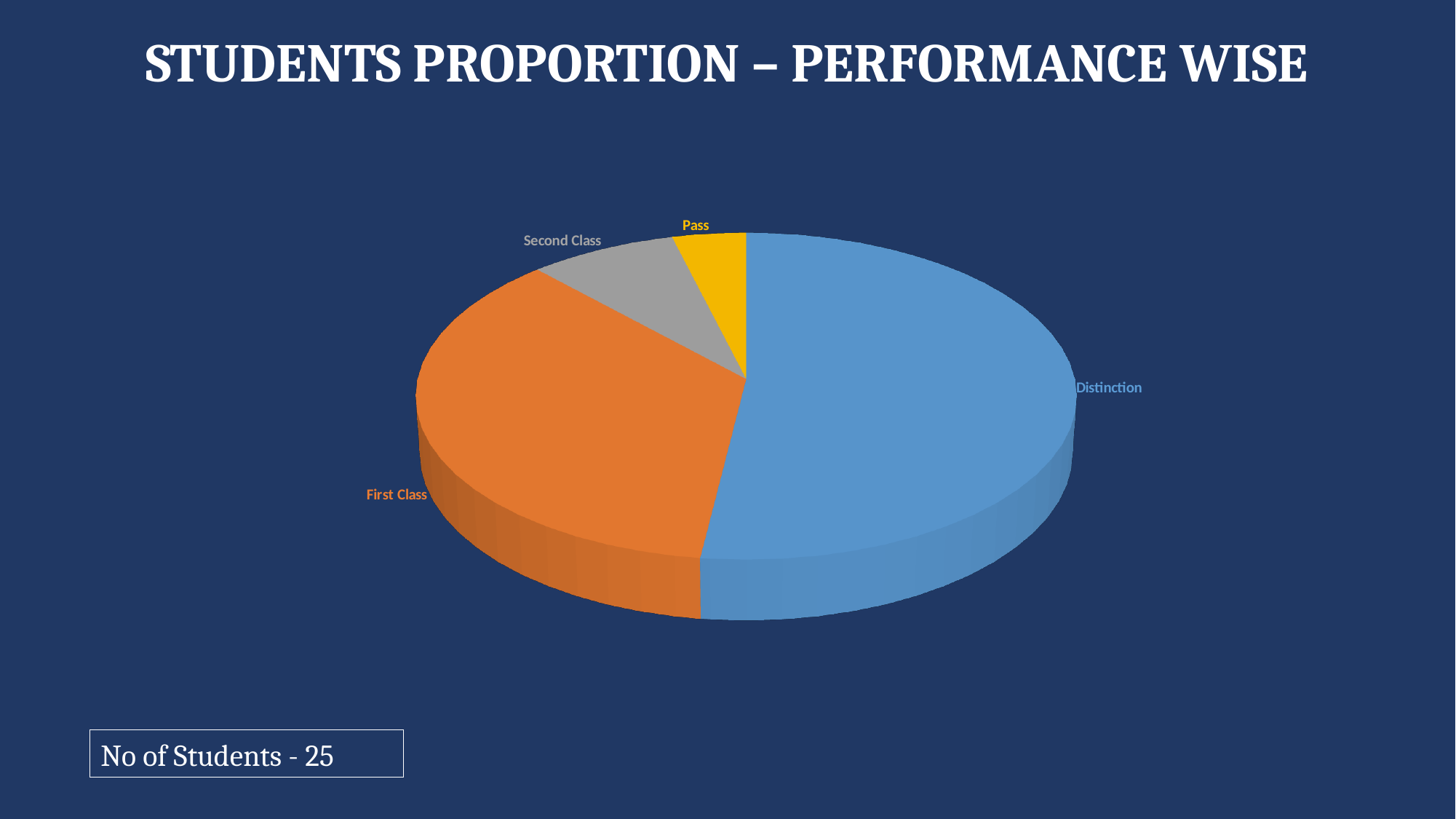
Which slice is larger, Second Class or Pass? Second Class What kind of chart is shown on the slide? pie chart What is the title of the slide containing the pie chart? STUDENTS PROPORTION – PERFORMANCE WISE How many slices does the pie chart have? 4 Which slice is larger, First Class or Second Class? First Class Which category has the largest slice of the pie chart? Distinction What colour is the First Class slice of the pie chart? orange Which category has the smallest slice of the pie chart? Pass Which slice is larger, Distinction or First Class? Distinction